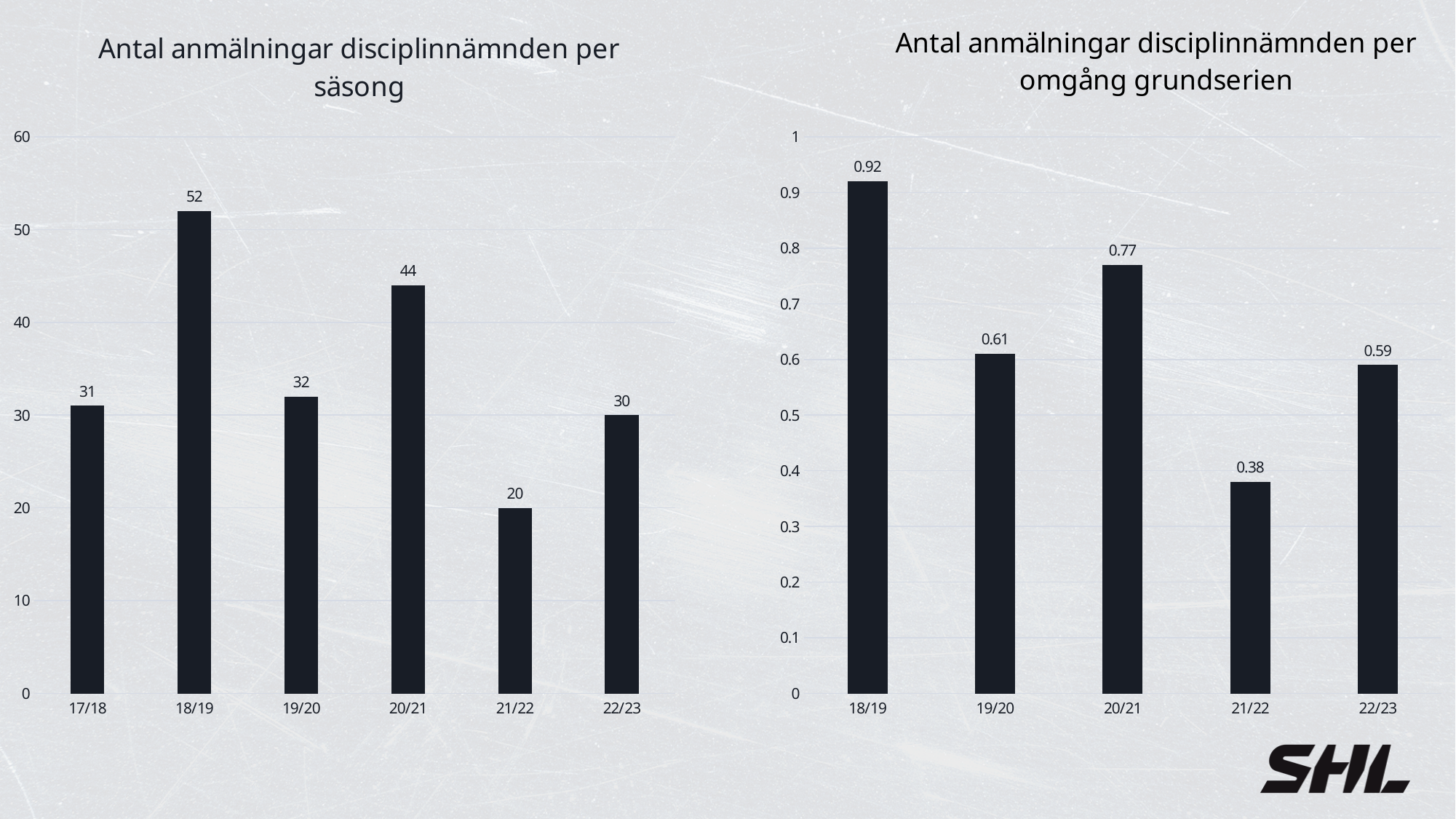
In the right chart 'Antal anmälningar disciplinnämnden per omgång grundserien', is the value for 19/20 greater or less than 0.5? greater In the left chart 'Antal anmälningar disciplinnämnden per säsong', which season has the lowest value? 21/22 In the left chart 'Antal anmälningar disciplinnämnden per säsong', how many seasons are shown on the x axis? 6 In the left chart 'Antal anmälningar disciplinnämnden per säsong', which is larger, the value for 17/18 or the value for 19/20? 19/20 What kind of chart is the left chart 'Antal anmälningar disciplinnämnden per säsong'? bar chart In the left chart 'Antal anmälningar disciplinnämnden per säsong', what is the difference between the values for 20/21 and 22/23? 14 In the left chart 'Antal anmälningar disciplinnämnden per säsong', what is the value for 18/19? 52 In the right chart 'Antal anmälningar disciplinnämnden per omgång grundserien', which season has the highest value? 18/19 What is the title of the right chart on the slide? Antal anmälningar disciplinnämnden per omgång grundserien In the right chart 'Antal anmälningar disciplinnämnden per omgång grundserien', what is the value for 20/21? 0.77 In the right chart 'Antal anmälningar disciplinnämnden per omgång grundserien', how many seasons are shown on the x axis? 5 In the right chart 'Antal anmälningar disciplinnämnden per omgång grundserien', what is the difference between the values for 18/19 and 21/22? 0.54